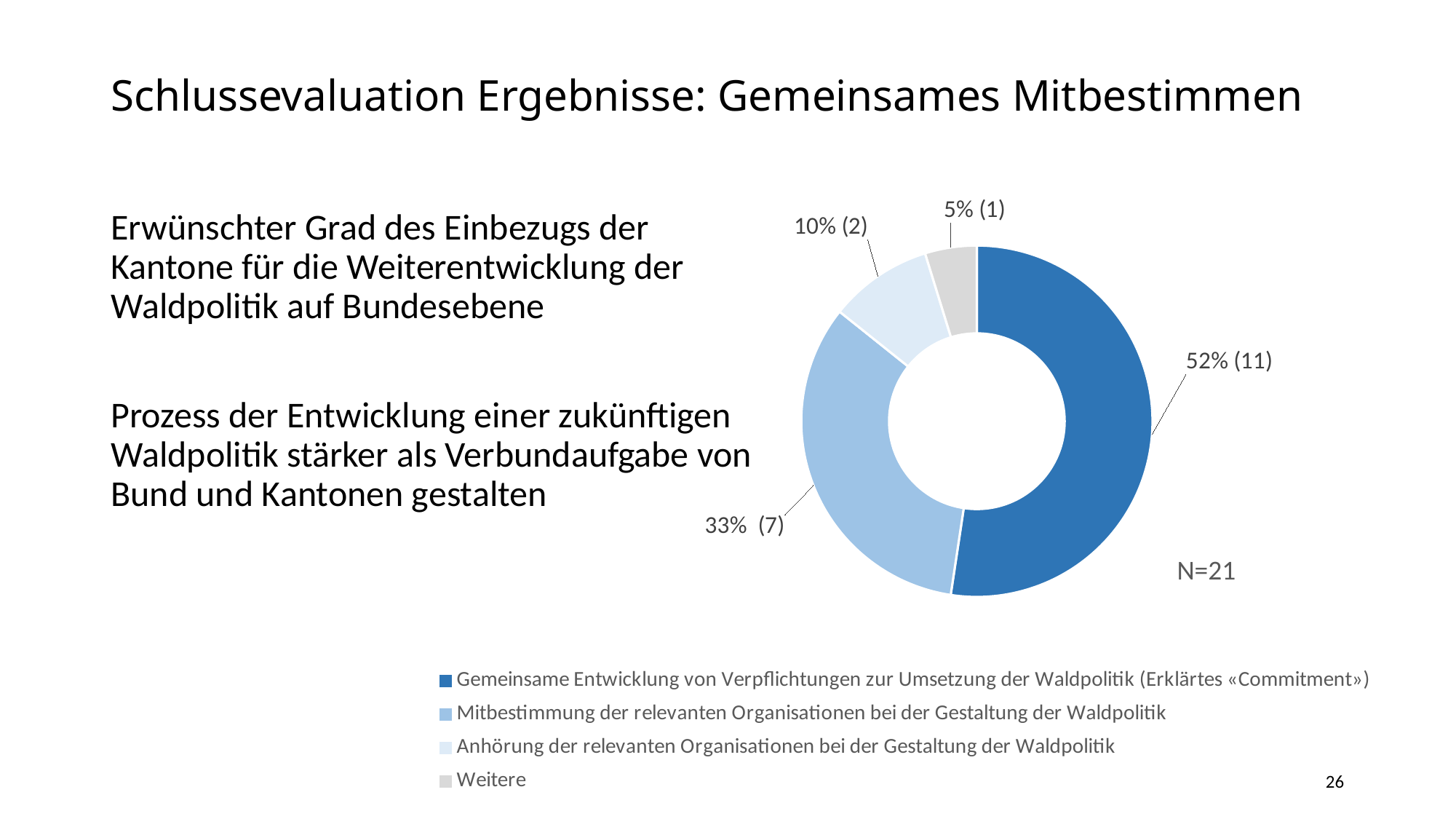
Which slice is larger: 'Anhörung der relevanten Organisationen' or 'Weitere'? Anhörung der relevanten Organisationen Which category has the smallest share of the chart? Weitere How many categories does the chart show? 4 What is the difference in percentage points between the 'Gemeinsame Entwicklung von Verpflichtungen' slice and the 'Mitbestimmung der relevanten Organisationen' slice? 19 percentage points What percentage share does the slice 'Gemeinsame Entwicklung von Verpflichtungen zur Umsetzung der Waldpolitik (Erklärtes «Commitment»)' have? 52% Which category has the largest share of the chart? Gemeinsame Entwicklung von Verpflichtungen zur Umsetzung der Waldpolitik (Erklärtes «Commitment») What is the total number of responses (N) shown next to the chart? N=21 How many responses does the slice 'Mitbestimmung der relevanten Organisationen bei der Gestaltung der Waldpolitik' represent? 7 How many responses does the 'Weitere' slice represent? 1 What colour is the 'Weitere' slice in the chart? Grey What kind of chart is shown on the slide? Doughnut (pie) chart What percentage share does the slice 'Anhörung der relevanten Organisationen bei der Gestaltung der Waldpolitik' have? 10%